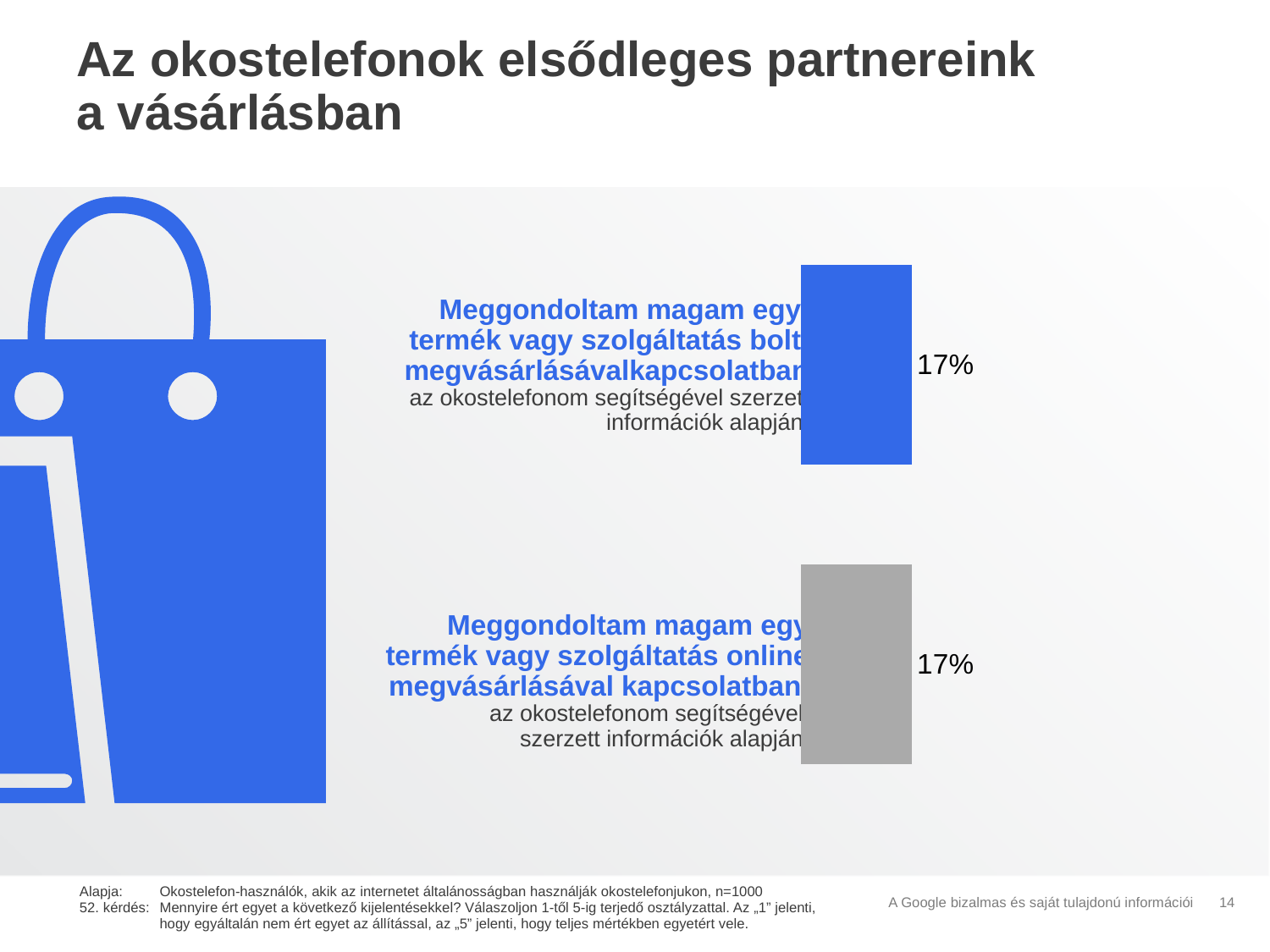
Are the bars in the chart oriented horizontally or vertically? Horizontally What is the difference between the value for in-store (boltban) purchases and the value for online purchases? 0 percentage points What colour is the bar for the in-store (boltban) purchase statement? Blue What is the value for the bar about changing one's mind regarding buying a product or service online based on information obtained with a smartphone? 17% What is the value for the bar about changing one's mind regarding buying a product or service in a store (boltban) based on information obtained with a smartphone? 17% What is the total of the two bar values shown in the chart? 34% How many bars are plotted in the chart? 2 What colour is the bar for the online purchase statement? Grey What kind of chart is shown on the slide? Bar chart Is the value for in-store (boltban) purchases larger than, smaller than, or equal to the value for online purchases? Equal